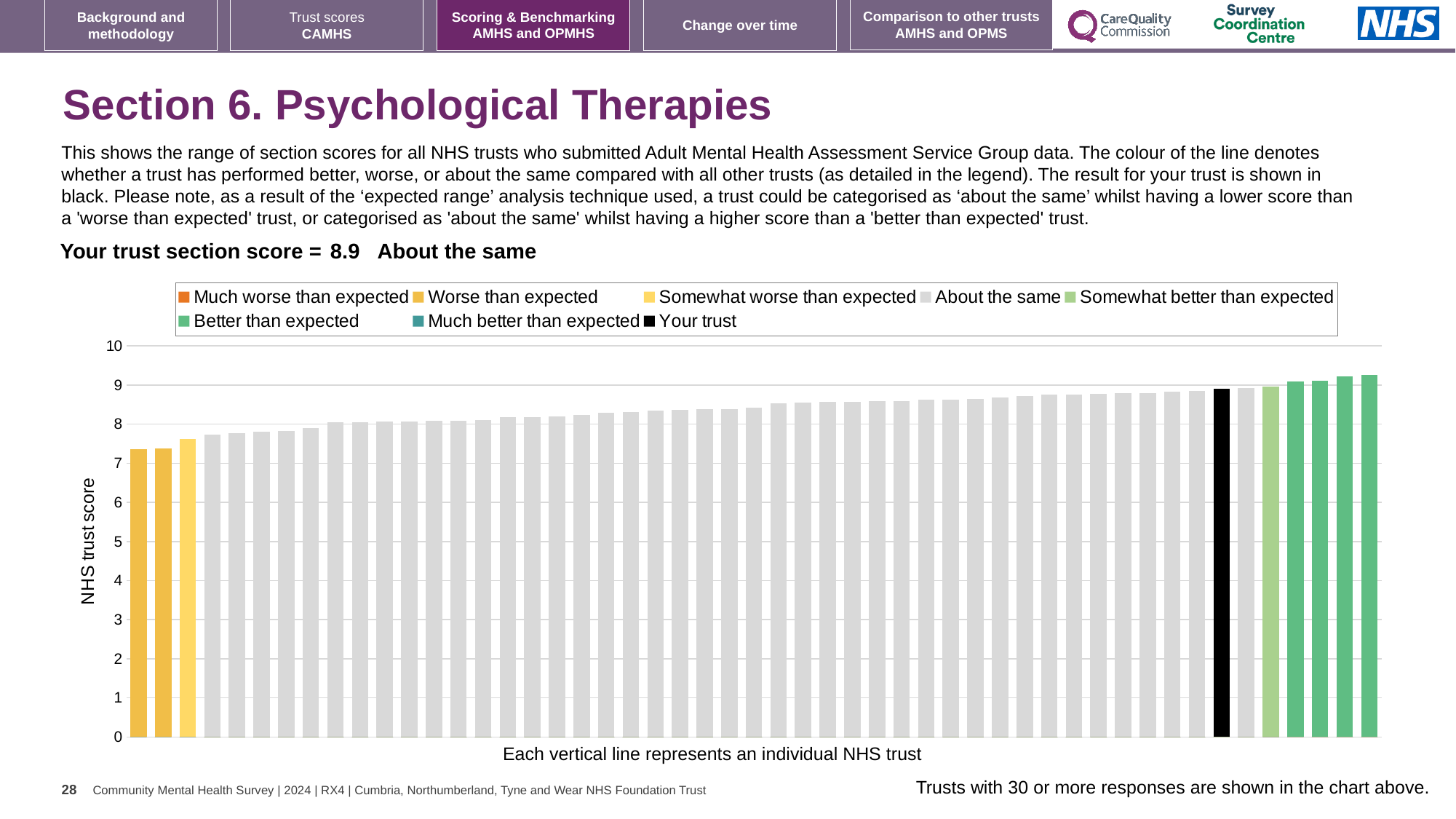
Which is taller: the black 'Your trust' bar or the leftmost bar? The black 'Your trust' bar Is the value of the black 'Your trust' bar greater or less than 8? greater What is your trust's section score for Psychological Therapies? 8.9 Is the value of the rightmost bar greater or less than 9? greater Do the bar values rise or fall from left to right along the x axis? Rise Which category is your trust placed in for this section? About the same What colour is the bar representing your trust? Black What is the label on the vertical axis of the chart? NHS trust score How many entries does the chart legend list? 8 Is the value of the leftmost bar greater or less than 8? less What kind of chart is shown on the slide? Bar chart Which is taller: the black 'Your trust' bar or the rightmost bar? The rightmost bar